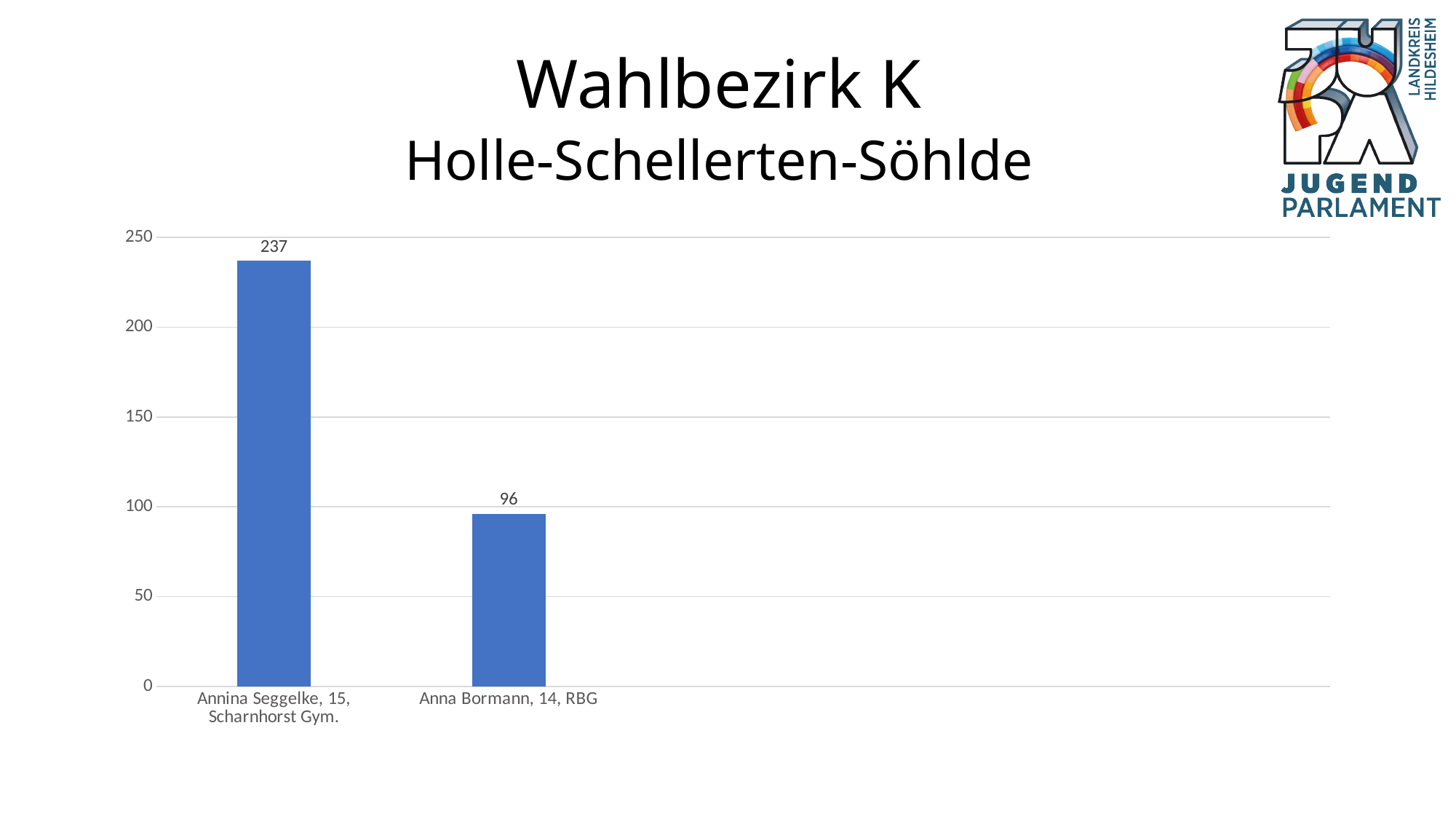
What value is shown for Annina Seggelke, 15, Scharnhorst Gym.? 237 Is the value for Anna Bormann, 14, RBG greater or less than 100? less Who has the larger value, Annina Seggelke or Anna Bormann? Annina Seggelke What value is shown for Anna Bormann, 14, RBG? 96 Which candidate has the lowest value? Anna Bormann, 14, RBG Which candidate has the highest value? Annina Seggelke, 15, Scharnhorst Gym. What is the total of the two values shown in the chart? 333 What kind of chart is shown on the slide? bar chart What is the title of the slide? Wahlbezirk K Holle-Schellerten-Söhlde What is the difference between the values for Annina Seggelke and Anna Bormann? 141 Is the value for Annina Seggelke, 15, Scharnhorst Gym. greater or less than 200? greater How many candidates are shown in the chart? 2